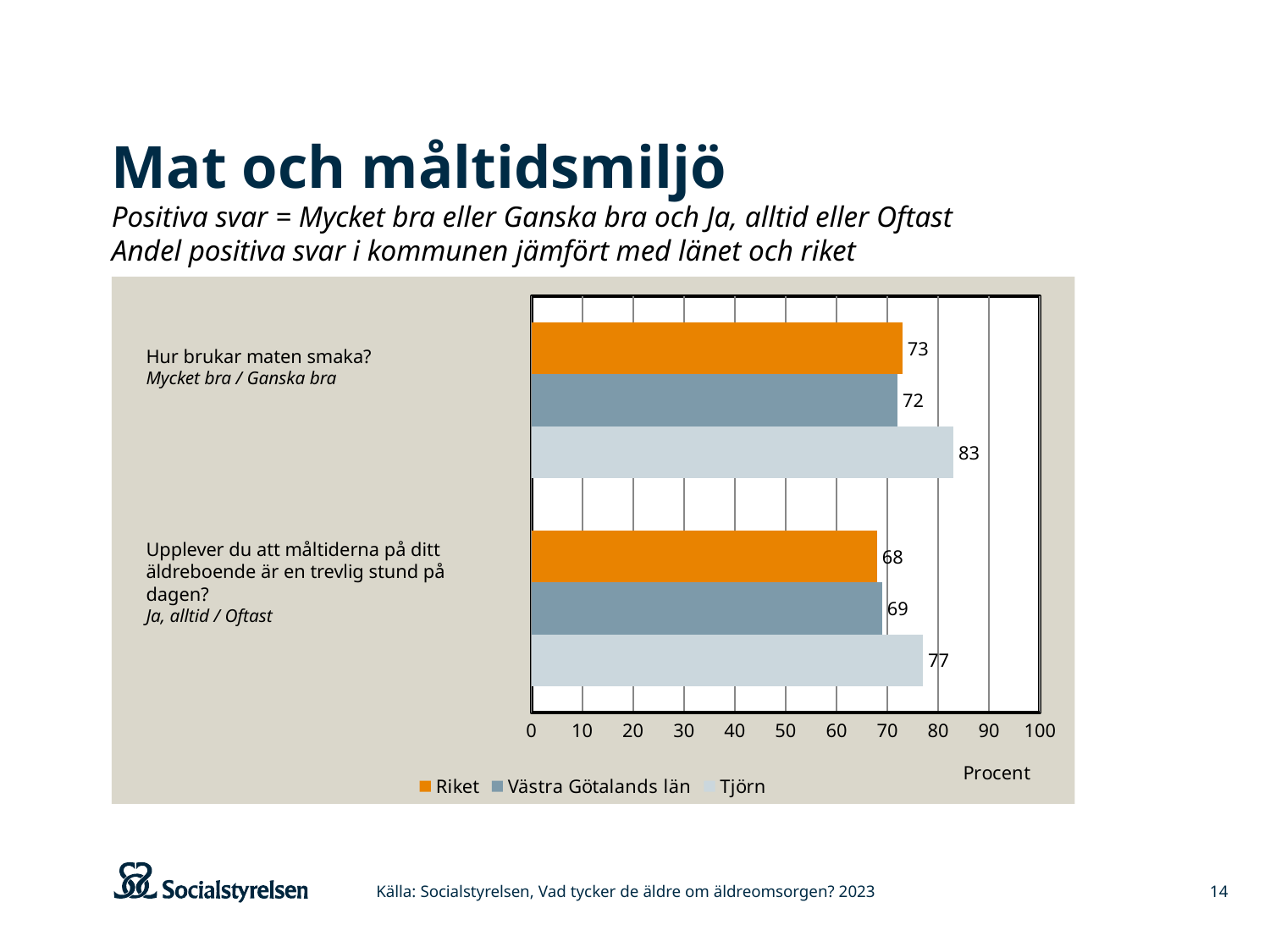
What value is shown for Riket on the question "Upplever du att måltiderna på ditt äldreboende är en trevlig stund på dagen?"? 68 What value is shown for Tjörn on the question "Hur brukar maten smaka?"? 83 How many series does the legend list? 3 Which is larger: the Tjörn value for "Hur brukar maten smaka?" or the Tjörn value for "Upplever du att måltiderna på ditt äldreboende är en trevlig stund på dagen?"? Hur brukar maten smaka? Is the Tjörn value for "Hur brukar maten smaka?" greater or less than 80? greater What is the difference between the Tjörn and Västra Götalands län values for "Upplever du att måltiderna på ditt äldreboende är en trevlig stund på dagen?"? 8 Which series has the lowest value for "Hur brukar maten smaka?"? Västra Götalands län What value is shown for Västra Götalands län on the question "Hur brukar maten smaka?"? 72 What kind of chart is shown on the slide? Bar chart What is the label of the horizontal axis? Procent Which series has the highest value for "Upplever du att måltiderna på ditt äldreboende är en trevlig stund på dagen?"? Tjörn What is the difference between the Tjörn and Riket values for "Hur brukar maten smaka?"? 10